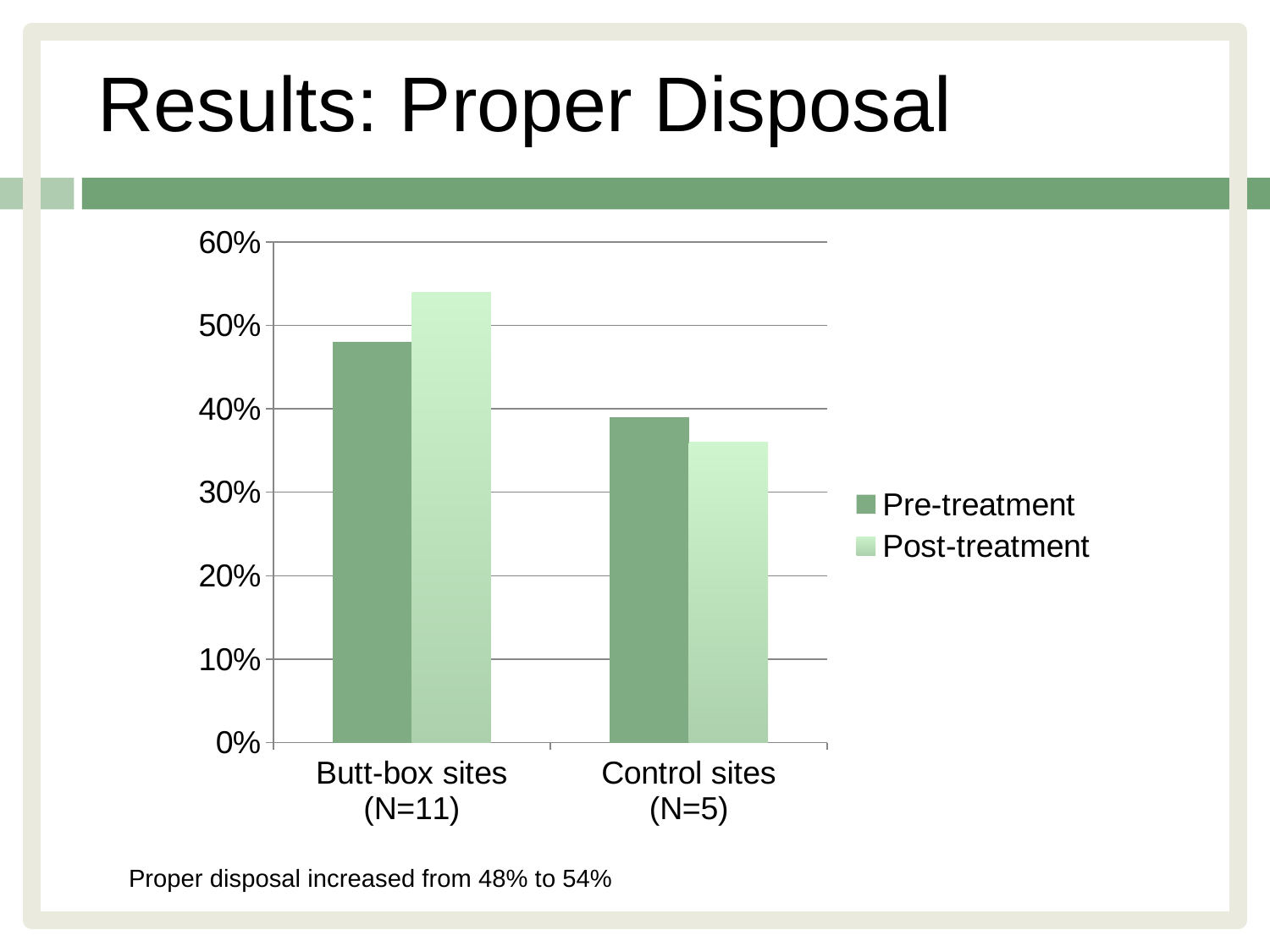
Which bar is the tallest in the chart? Post-treatment for Butt-box sites (N=11) Which bar is the shortest in the chart? Post-treatment for Control sites (N=5) Is the Pre-treatment value for Control sites (N=5) greater or less than 40%? less What type of chart is shown on the slide? bar chart How many categories are shown on the x axis? 2 Which series is shown in the darker green colour? Pre-treatment Is the Post-treatment value for Control sites (N=5) greater or less than 30%? greater How many series does the legend list? 2 For Butt-box sites (N=11), which is larger: Pre-treatment or Post-treatment? Post-treatment Is the Post-treatment value for Butt-box sites (N=11) greater or less than 50%? greater For Control sites (N=5), which is larger: Pre-treatment or Post-treatment? Pre-treatment According to the note below the chart, proper disposal increased from what value to what value? from 48% to 54%